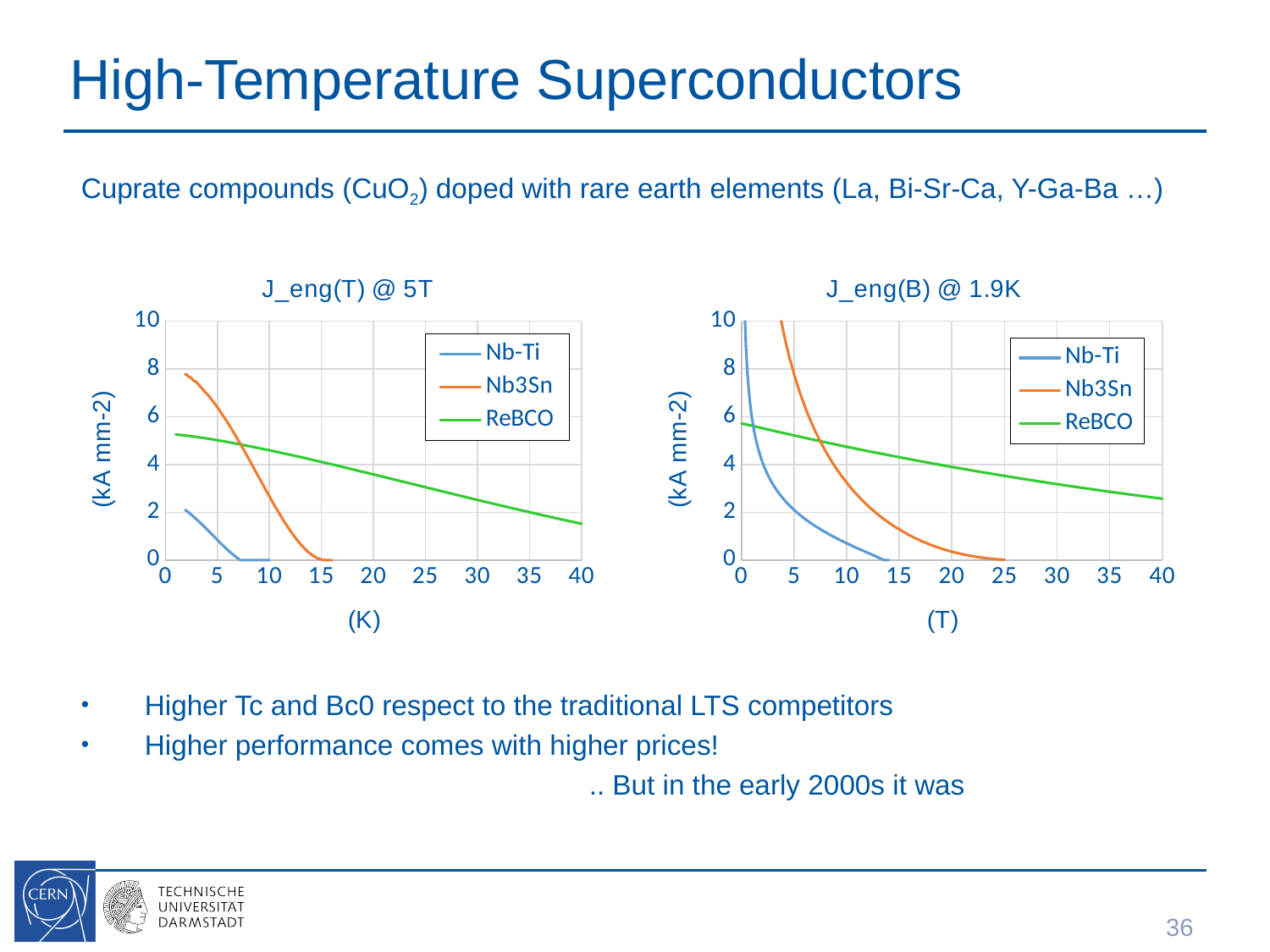
How many series does the legend of the right chart "J_eng(B) @ 1.9K" list? 3 In the left chart "J_eng(T) @ 5T", is the value for Nb3Sn at 2 K greater or less than 6? greater In the right chart "J_eng(B) @ 1.9K", is the value for Nb-Ti at 5 T greater or less than 4? less In the left chart "J_eng(T) @ 5T", is the value for ReBCO at 40 K greater or less than 2? less What is the y-axis label of the left chart "J_eng(T) @ 5T"? (kA mm-2) In the left chart "J_eng(T) @ 5T", which series has the larger value at 20 K, Nb3Sn or ReBCO? ReBCO What kind of chart is the left chart titled "J_eng(T) @ 5T"? line chart In the right chart "J_eng(B) @ 1.9K", which series has the larger value at 5 T, Nb3Sn or ReBCO? Nb3Sn In the right chart "J_eng(B) @ 1.9K", does the Nb-Ti curve rise or fall as the field increases along the x axis? fall In the left chart "J_eng(T) @ 5T", which series reaches zero at the lowest temperature? Nb-Ti In the left chart "J_eng(T) @ 5T", does the ReBCO curve rise or fall as temperature increases along the x axis? fall